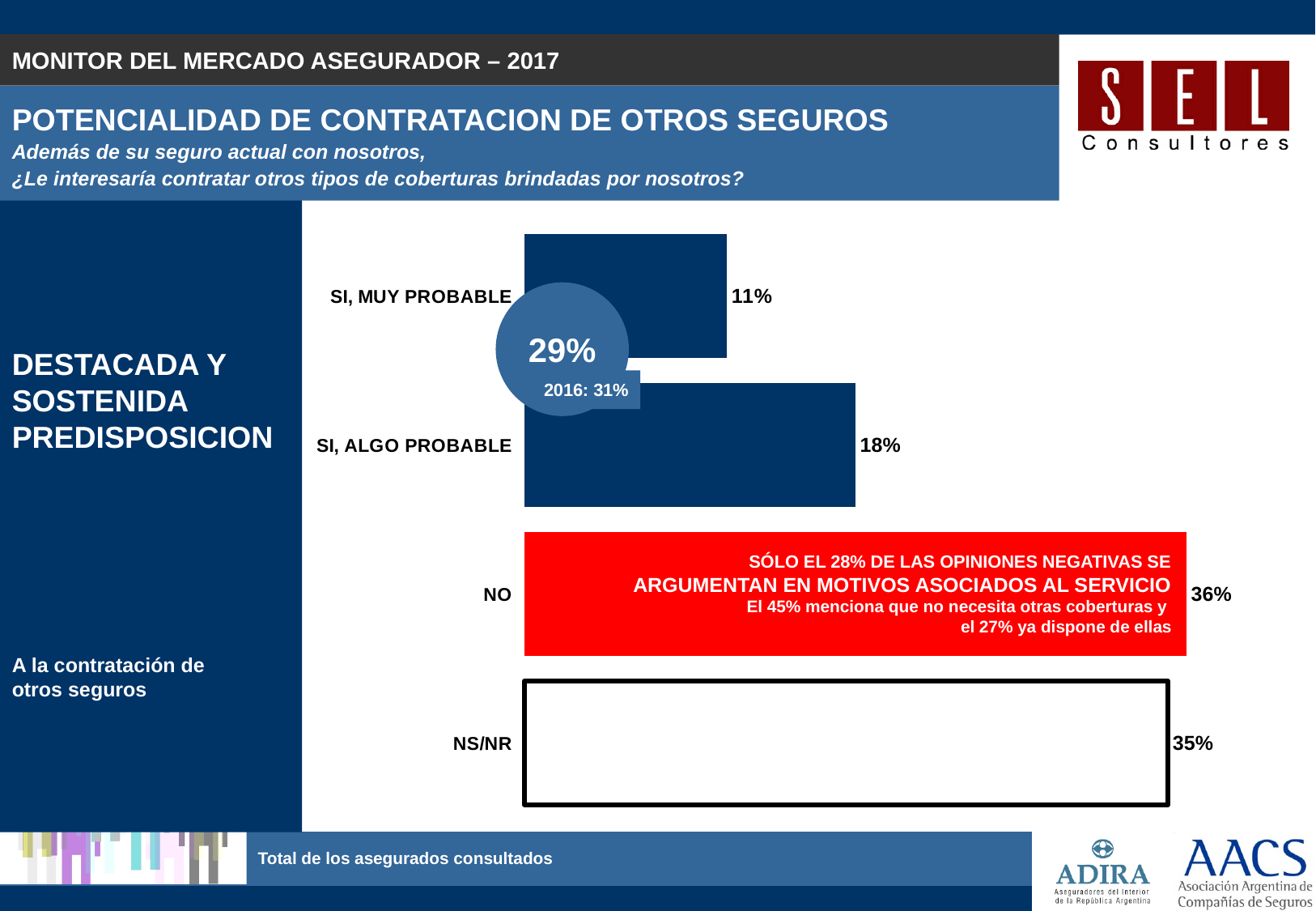
What is the difference between the values for NO and NS/NR? 1% What value is shown in the circle overlaid on the chart for 2016? 31% Which category has the highest value? NO What is the difference between the values for SI, ALGO PROBABLE and SI, MUY PROBABLE? 7% What is the value for SI, ALGO PROBABLE? 18% What is the value for SI, MUY PROBABLE? 11% Which is larger, the value for SI, ALGO PROBABLE or the value for SI, MUY PROBABLE? SI, ALGO PROBABLE What is the value for NS/NR? 35% What is the value for NO? 36% How many categories are shown in the chart? 4 What kind of chart is shown on the slide? Bar chart Which category has the lowest value? SI, MUY PROBABLE